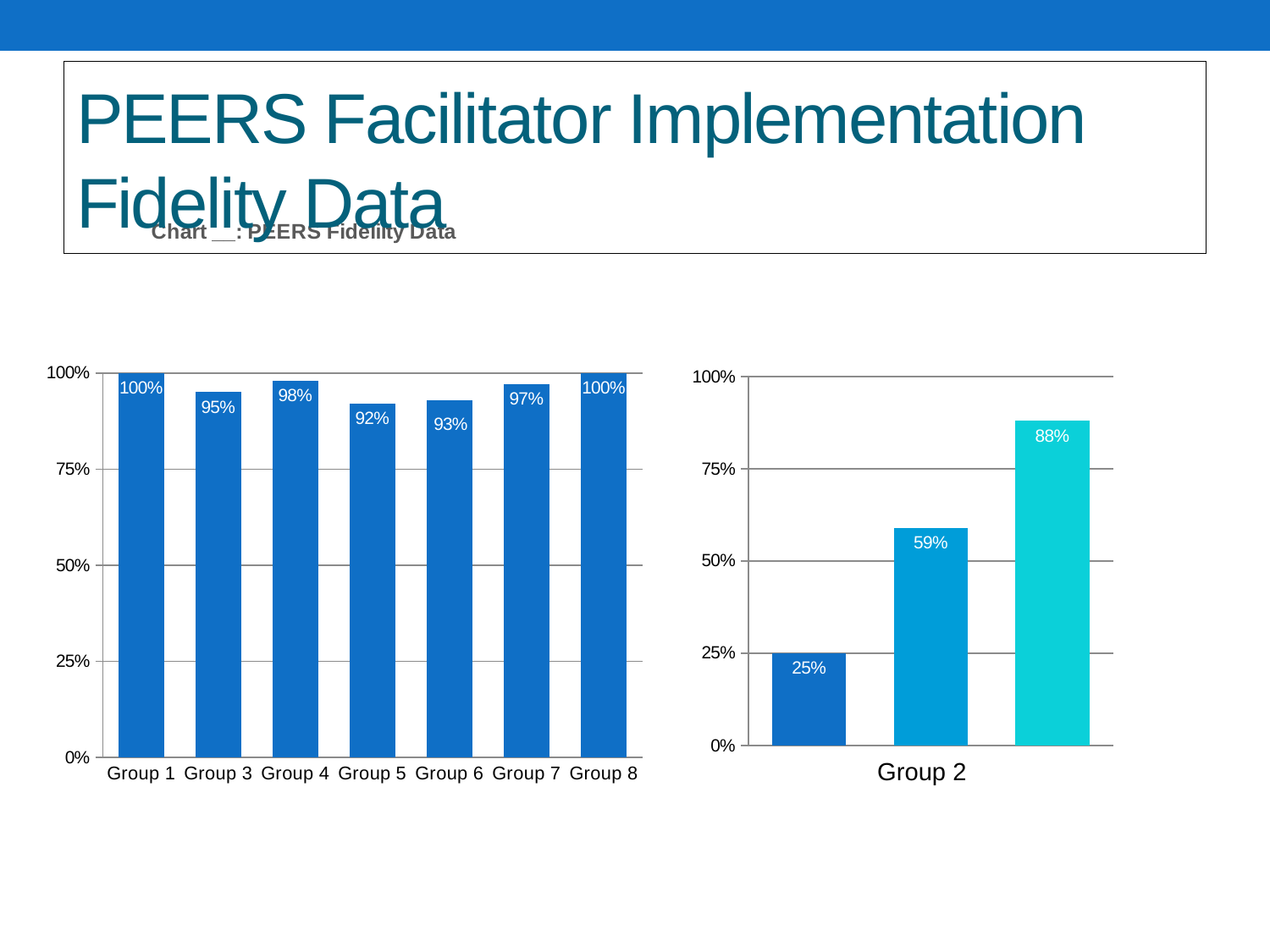
In the left chart, how many groups have a value of 100%? 2 In the left chart, what is the difference between the values for Group 4 and Group 6? 5% What type of chart is the left chart? bar chart In the left chart, which is larger, the value for Group 3 or the value for Group 7? Group 7 In the left chart, what is the value for Group 5? 92% In the right chart, what is the value of the first (leftmost) bar for Group 2? 25% In the right chart, do the bar values rise or fall from left to right? rise In the left chart, how many groups are shown on the x axis? 7 In the right chart, what is the value of the tallest bar for Group 2? 88% In the left chart, which group has the lowest value? Group 5 In the left chart, what is the value for Group 3? 95% In the right chart, what is the difference between the third bar and the second bar for Group 2? 29%